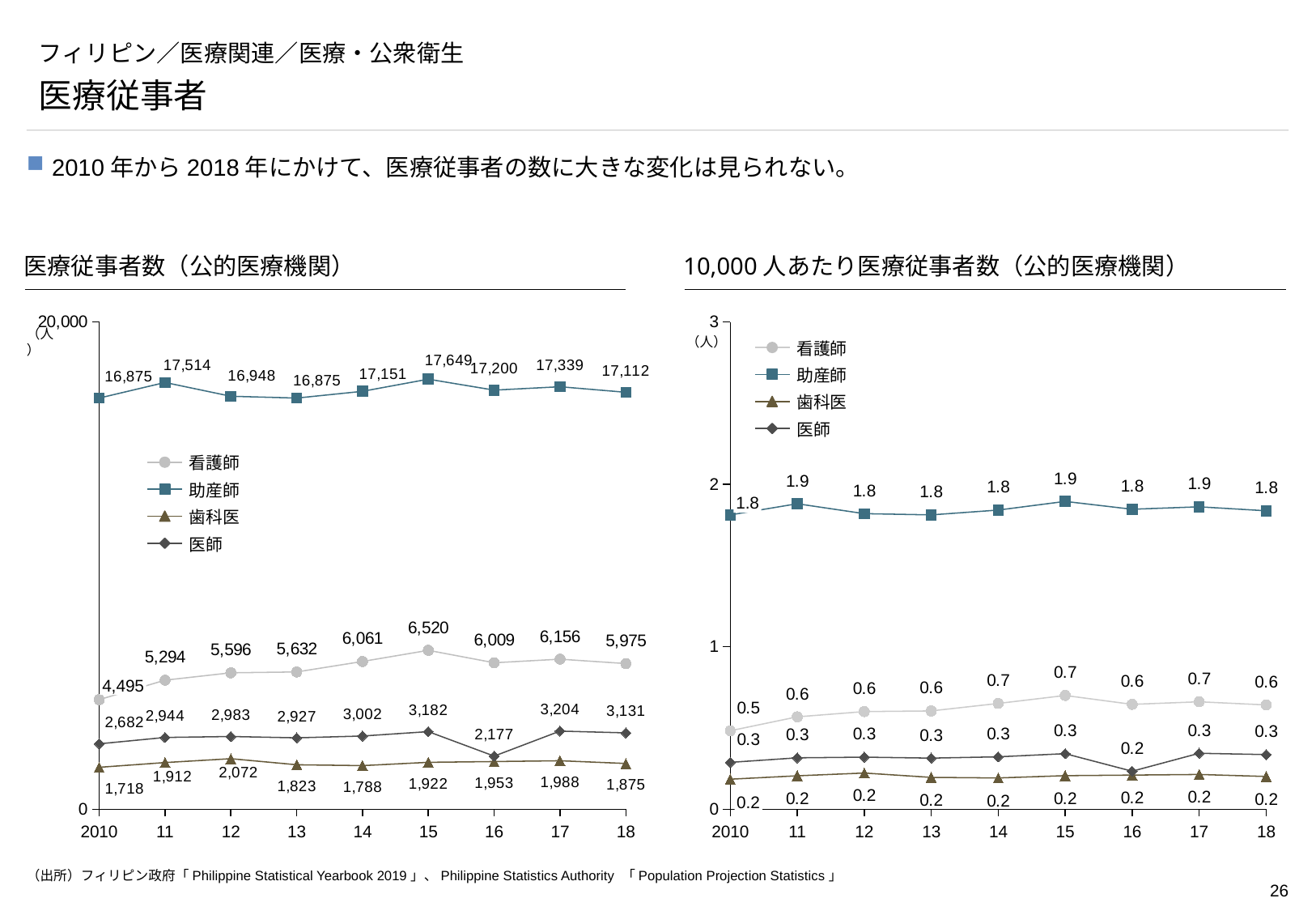
In the left chart (医療従事者数（公的医療機関）), in which year is the 医師 value lowest? 2016 In the left chart (医療従事者数（公的医療機関）), what is the value for 看護師 in 2010? 4,495 In the right chart (10,000人あたり医療従事者数（公的医療機関）), what is the value for 医師 in 2016? 0.2 In the right chart (10,000人あたり医療従事者数（公的医療機関）), what is the value for 看護師 in 2014? 0.7 In the left chart (医療従事者数（公的医療機関）), what is the difference between the 看護師 value in 2018 and the 医師 value in 2018? 2,844 In the left chart (医療従事者数（公的医療機関）), how many series does the legend list? 4 In the left chart (医療従事者数（公的医療機関）), which is larger: the 歯科医 value in 2012 or the 歯科医 value in 2017? 2012 In the right chart (10,000人あたり医療従事者数（公的医療機関）), which series has the highest values across all years? 助産師 In the left chart (医療従事者数（公的医療機関）), how many years are plotted on the x axis? 9 In the left chart (医療従事者数（公的医療機関）), what is the value for 助産師 in 2015? 17,649 In the left chart (医療従事者数（公的医療機関）), in which year is the 看護師 value highest? 2015 What kind of chart is the right chart (10,000人あたり医療従事者数（公的医療機関）)? Line chart